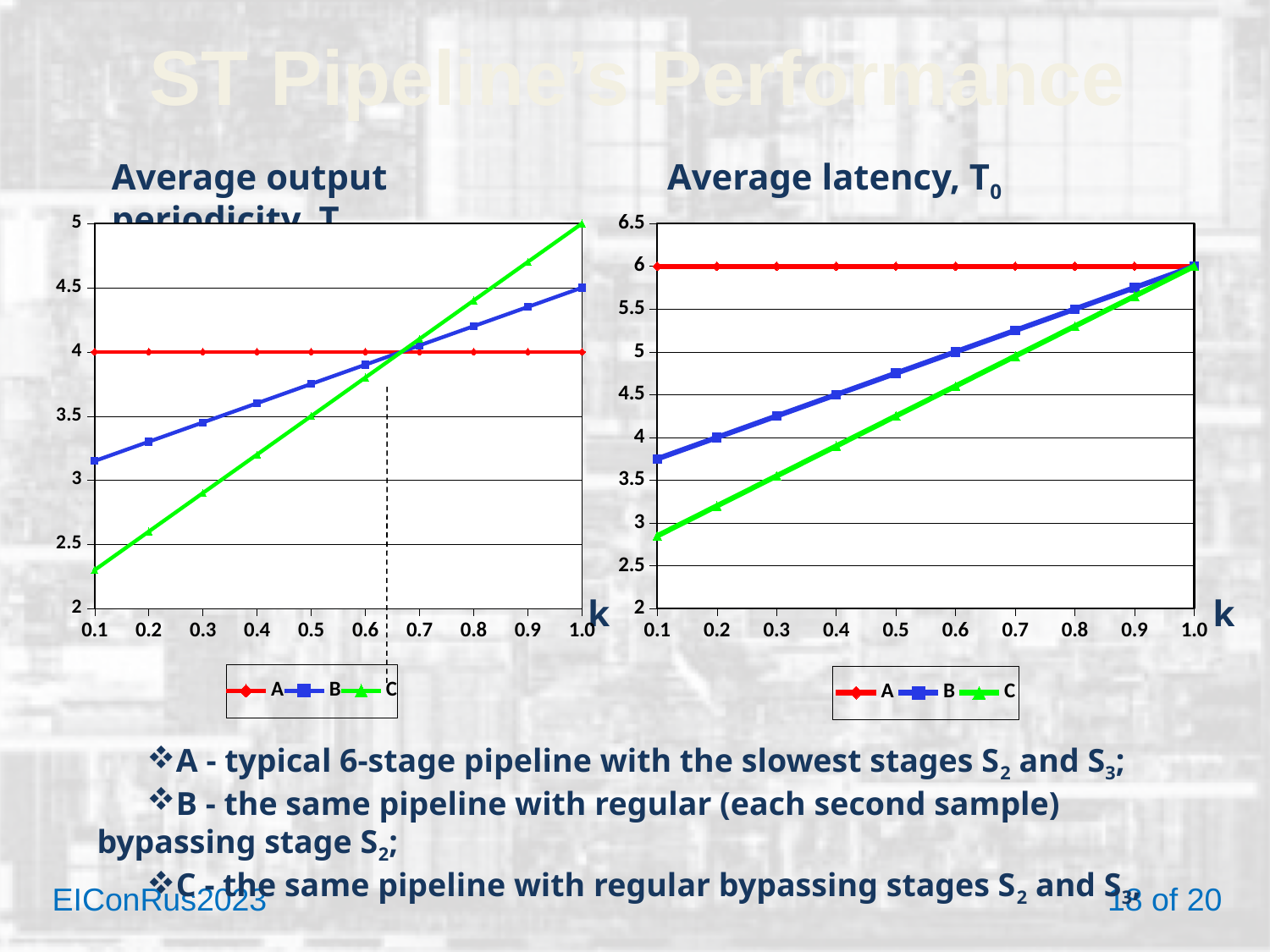
In the right chart (Average latency, T0), what is the value of series B at k = 0.6? 5 How many series does the legend of the left chart list? 3 In the right chart (Average latency, T0), what is the value of series A at k = 0.5? 6 What kind of chart is the 'Average latency, T0' chart on the right? line chart In the right chart (Average latency, T0), which series has the lowest value at k = 0.1? C In the left chart, what is the value of series A at k = 0.5? 4 In the left chart, which series has the highest value at k = 1.0? C In the left chart, is the value of series C at k = 0.1 greater or less than 2.5? less In the left chart, what is the value of series C at k = 1.0? 5 How many k values are plotted along the x axis of the right chart? 10 In the right chart (Average latency, T0), at k = 0.3, which series has the larger value, B or C? B In the right chart (Average latency, T0), does series C rise or fall as k increases? rises